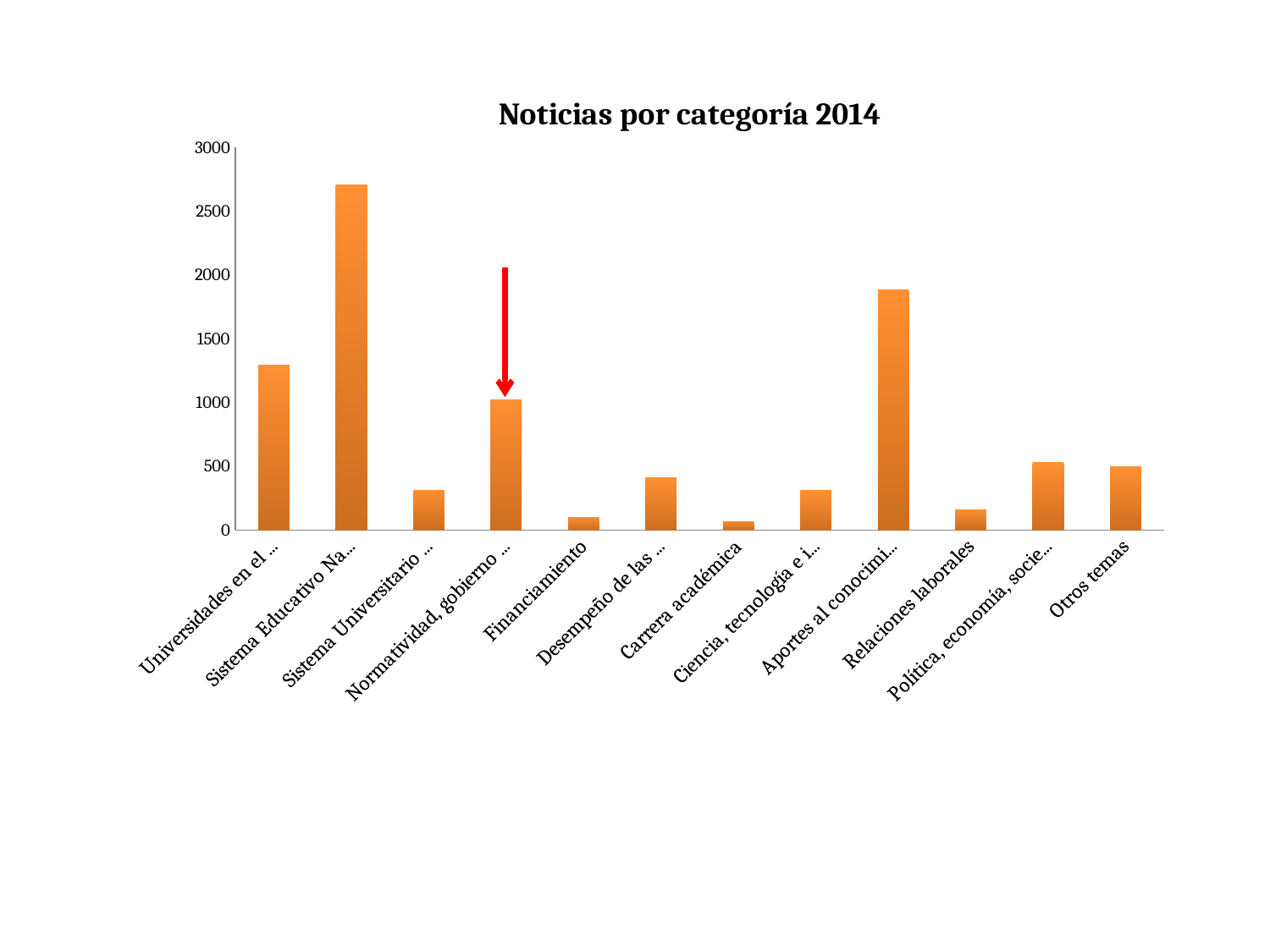
Which category's bar does the red arrow point to? Normatividad, gobierno ... What is the title of the chart? Noticias por categoría 2014 How many categories are plotted in the chart? 12 Is the value for Otros temas greater or less than 1000? less Which is larger, the value for Financiamiento or the value for Carrera académica? Financiamiento Which category has the lowest value in the chart? Carrera académica What kind of chart is shown on the slide? Bar chart Is the value for Aportes al conocimi... greater or less than 1500? greater Which category has the highest value in the chart? Sistema Educativo Na... Is the value for Financiamiento greater or less than 500? less Which is larger, the value for Relaciones laborales or the value for Otros temas? Otros temas